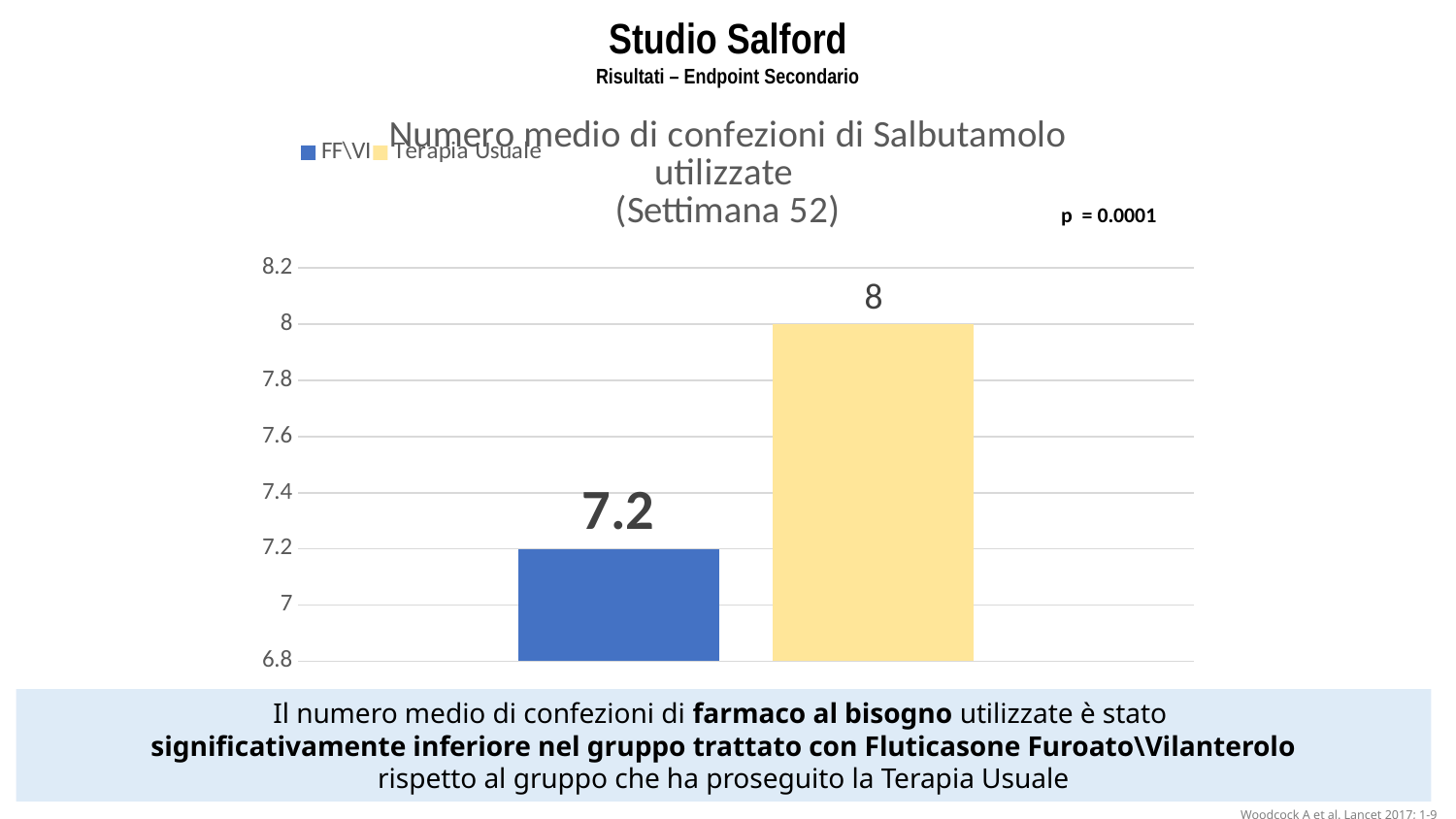
Is the value for Terapia Usuale greater or less than 7.8? greater What kind of chart is shown on the slide? bar chart Which is larger, the value for FF\VI or the value for Terapia Usuale? Terapia Usuale Which series has the highest value? Terapia Usuale Is the value for FF\VI greater or less than 7.4? less How many bars are plotted in the chart? 2 What is the value for Terapia Usuale? 8 Which series has the lowest value? FF\VI What p-value is shown next to the chart? p = 0.0001 What is the value for FF\VI? 7.2 What is the difference between the Terapia Usuale value and the FF\VI value? 0.8 How many series does the legend list? 2